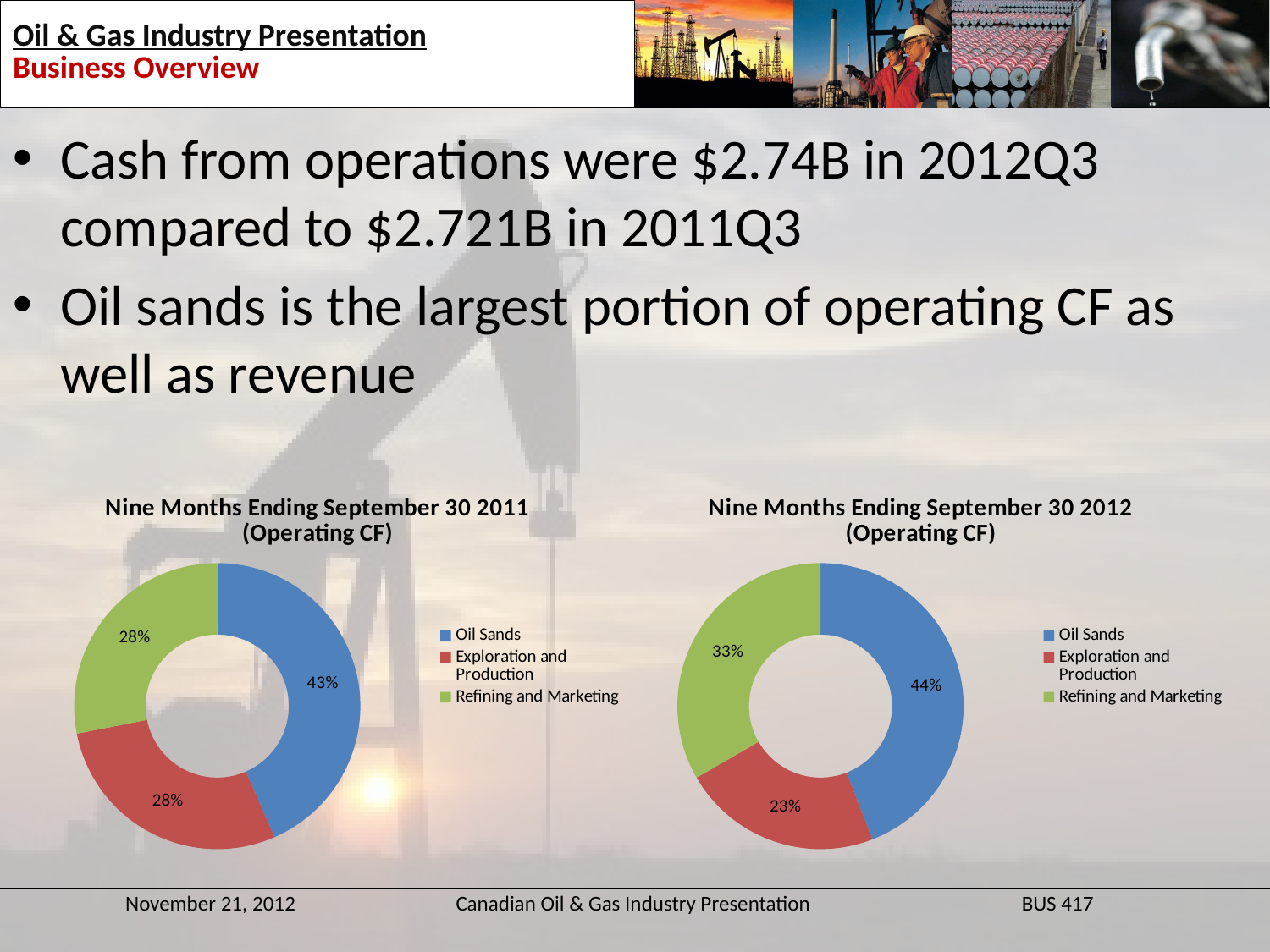
In the 'Nine Months Ending September 30 2012 (Operating CF)' chart, which segment has the smallest share? Exploration and Production What kind of chart is the 'Nine Months Ending September 30 2012 (Operating CF)' chart? Doughnut (pie) chart In the 'Nine Months Ending September 30 2011 (Operating CF)' chart, what share does Refining and Marketing have? 28% In the 'Nine Months Ending September 30 2011 (Operating CF)' chart, what colour represents Oil Sands? Blue In the 'Nine Months Ending September 30 2012 (Operating CF)' chart, what share does Exploration and Production have? 23% In the 'Nine Months Ending September 30 2012 (Operating CF)' chart, which is larger: Refining and Marketing or Exploration and Production? Refining and Marketing In the 'Nine Months Ending September 30 2012 (Operating CF)' chart, what is the difference between the Oil Sands share and the Exploration and Production share? 21% In the 'Nine Months Ending September 30 2011 (Operating CF)' chart, which segment has the largest share? Oil Sands In the 'Nine Months Ending September 30 2012 (Operating CF)' chart, what share does Refining and Marketing have? 33% In the 'Nine Months Ending September 30 2012 (Operating CF)' chart, which segment has the largest share? Oil Sands How many segments does the 'Nine Months Ending September 30 2011 (Operating CF)' chart have? 3 In the 'Nine Months Ending September 30 2011 (Operating CF)' chart, what share does Oil Sands have? 43%